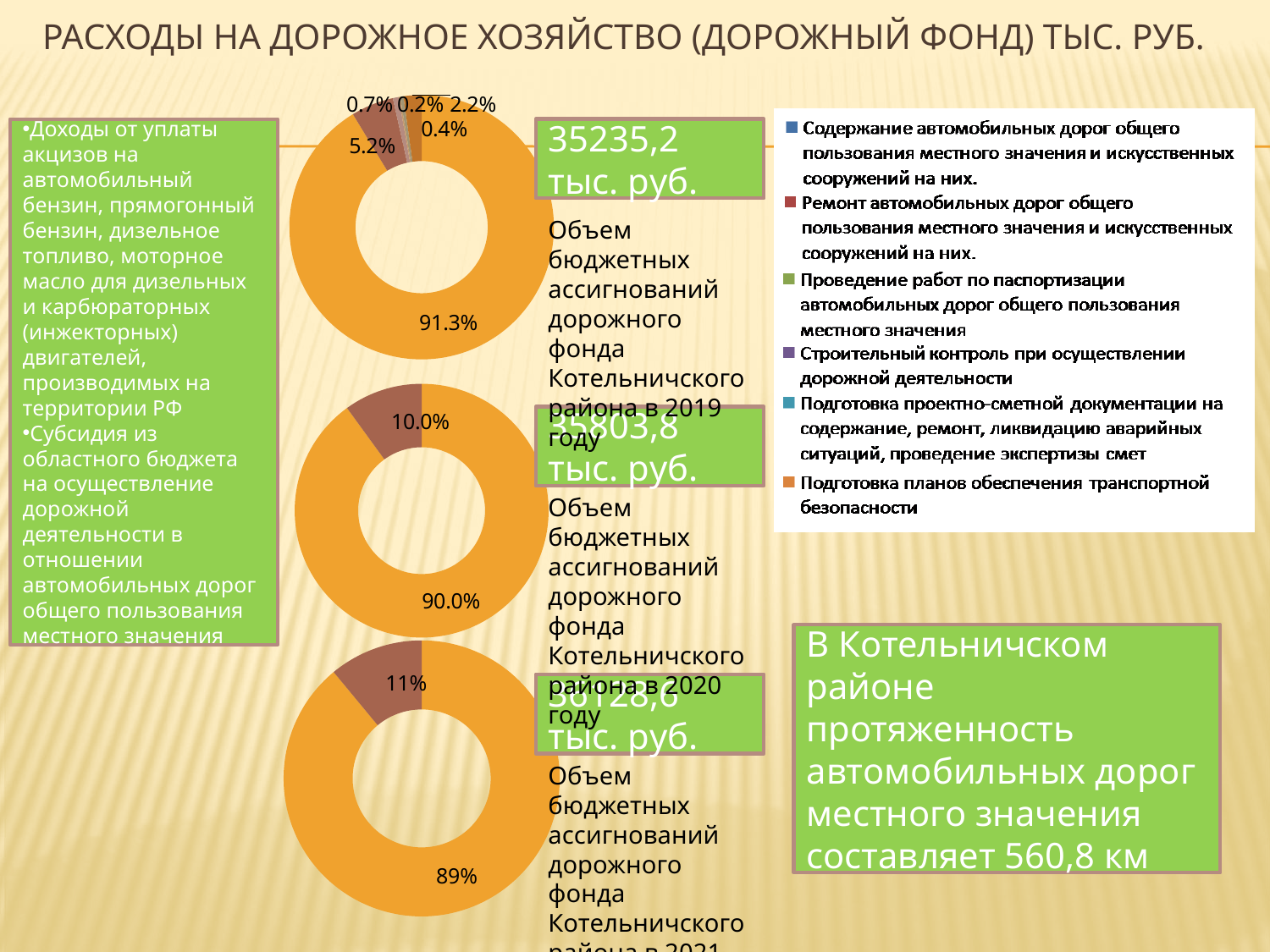
In the bottom doughnut chart (2021), what is the share of the largest slice? 89% In the bottom doughnut chart (2021), what is the difference between the two slices? 78% How many slices does the middle doughnut chart (2020) have? 2 In the top doughnut chart (2019), which is larger: the slice labelled 5.2% or the slice labelled 2.2%? 5.2% How many slices are labelled in the top doughnut chart (2019)? 6 How many entries does the legend on the right list? 6 In the middle doughnut chart (2020), what is the share of the smaller slice? 10.0% What kind of chart is used for the three charts on the left of the slide? Doughnut (pie) chart In the middle doughnut chart (2020), what is the difference between the two slices? 80.0% In the top doughnut chart (2019), what is the share of the largest slice? 91.3% Does the share of the largest slice rise or fall from the 2019 chart to the 2021 chart? Fall In the top doughnut chart (2019), what is the share of the smallest labelled slice? 0.2%